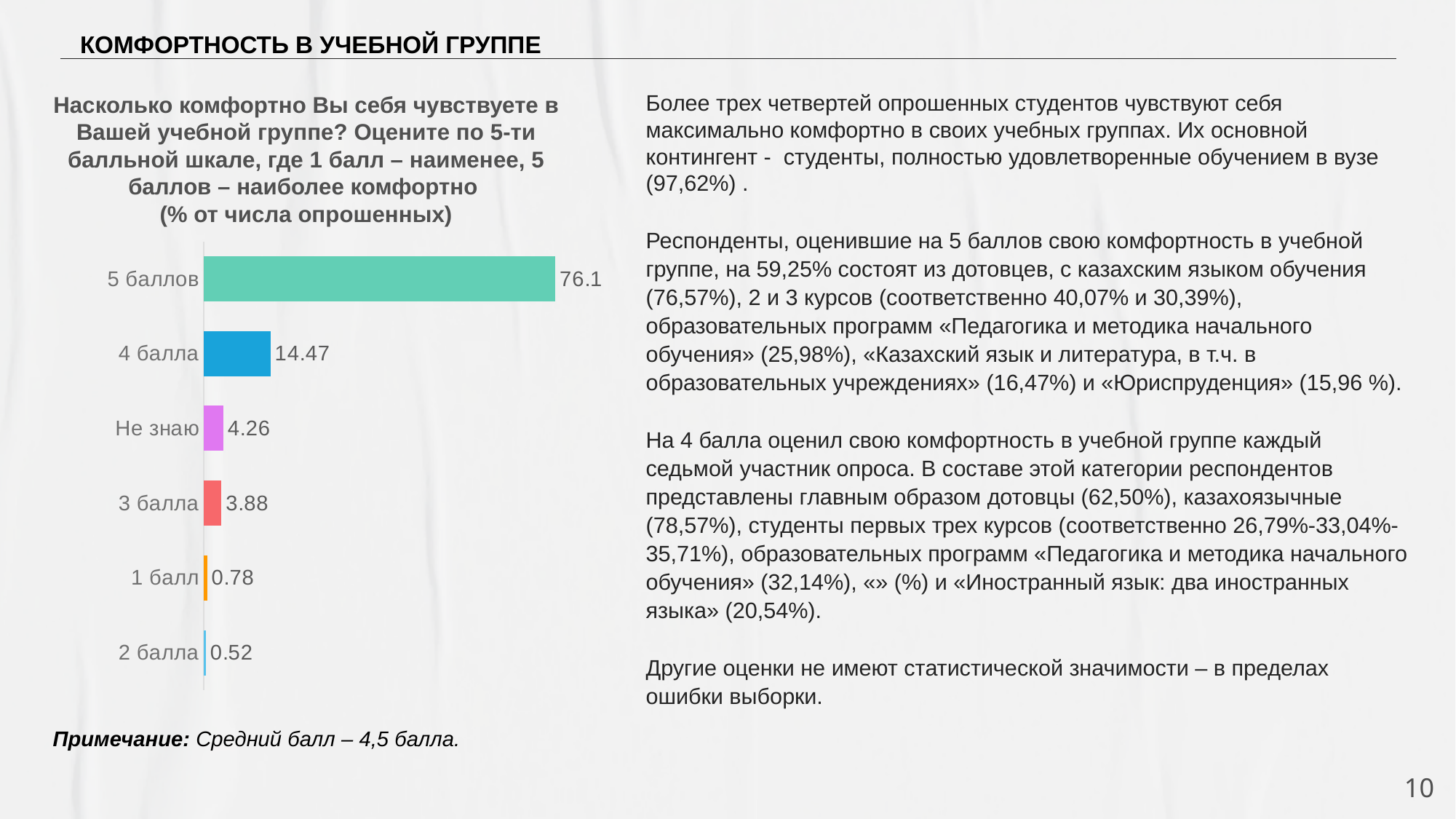
What colour is the bar for "5 баллов"? green What is the difference between the values for "5 баллов" and "4 балла"? 61.63 Which is larger, the value for "Не знаю" or the value for "3 балла"? Не знаю What kind of chart is shown on the slide? bar chart What is the difference between the values for "3 балла" and "1 балл"? 3.1 Which category has the lowest value? 2 балла Which category has the highest value? 5 баллов What is the value for "Не знаю"? 4.26 What is the value for "4 балла"? 14.47 What is the value for "5 баллов"? 76.1 What is the value for "2 балла"? 0.52 How many categories are shown in the chart? 6